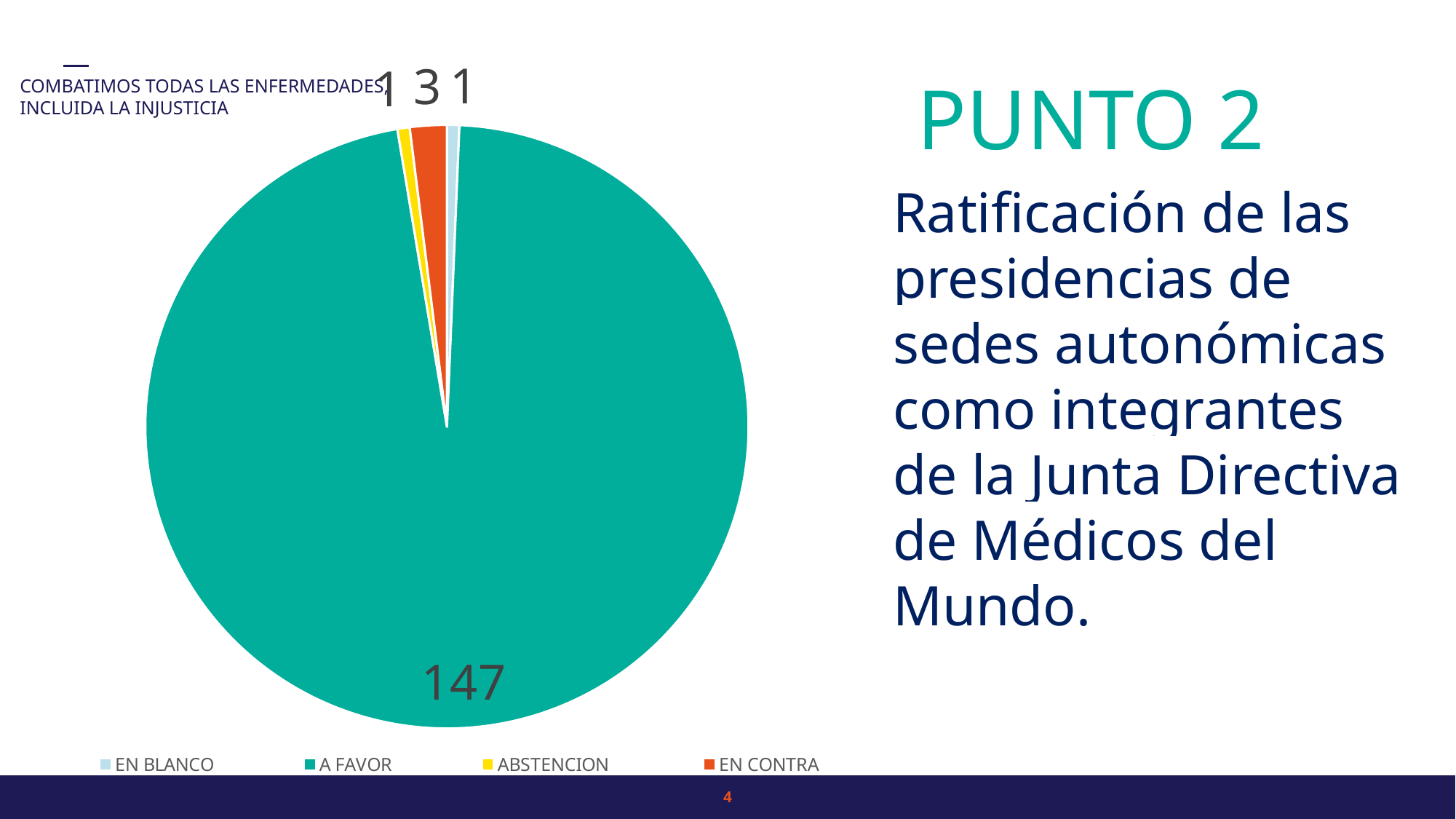
How many votes are shown for EN BLANCO? 1 How many entries does the legend list? 4 What is the difference between the A FAVOR and EN CONTRA values? 144 What type of chart is shown on the slide? Pie chart How many categories does the pie chart have? 4 What is the total of all the values in the pie chart? 152 How many votes are shown for ABSTENCION? 1 What colour is the A FAVOR slice? Teal Which category has the largest slice of the pie? A FAVOR How many votes are shown for A FAVOR? 147 Which is larger, EN CONTRA or ABSTENCION? EN CONTRA How many votes are shown for EN CONTRA? 3